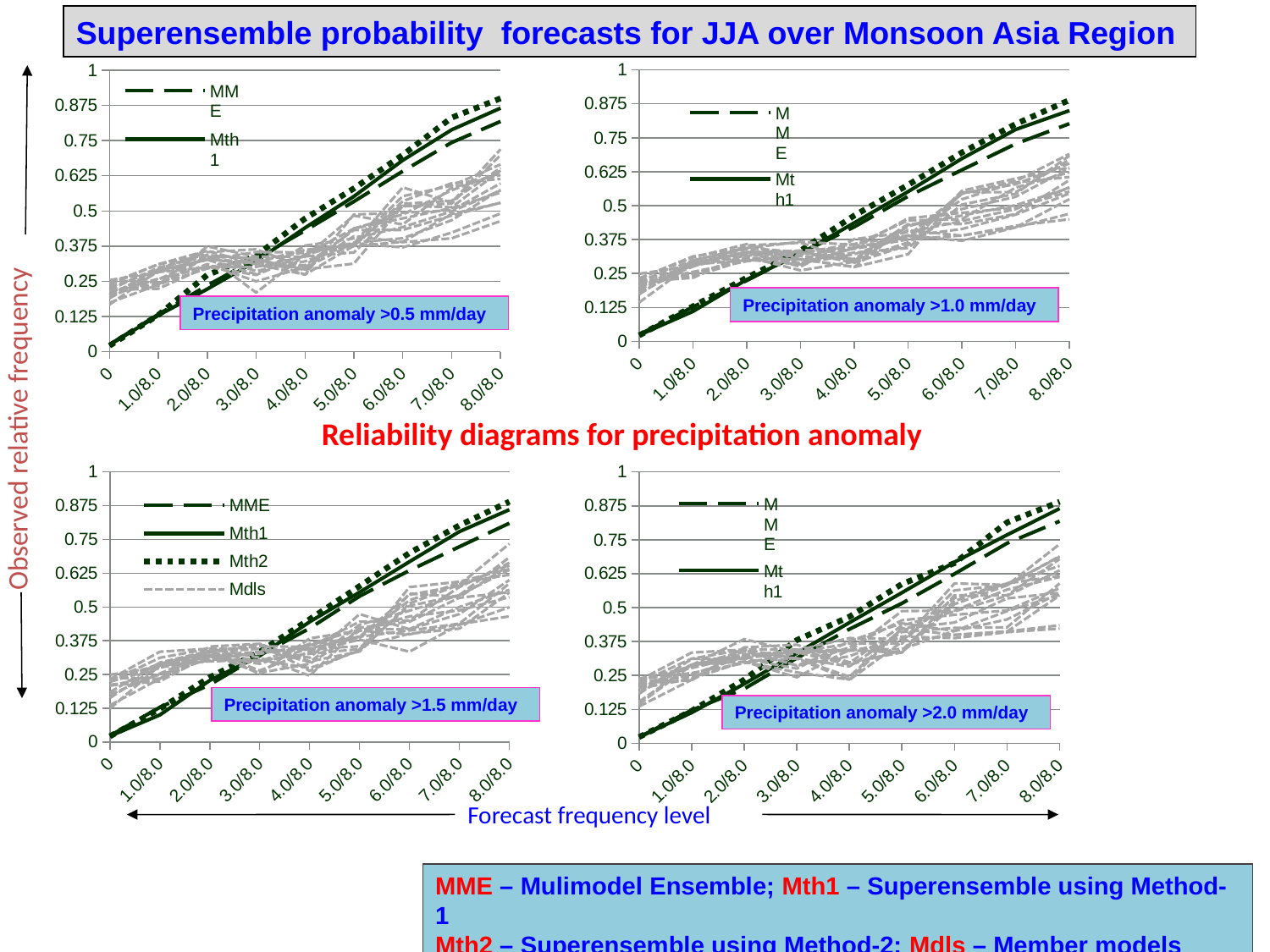
In the top-left chart (Precipitation anomaly >0.5 mm/day), does the Mth1 line rise or fall as the forecast frequency level increases from 0 to 8.0/8.0? rise What type of chart is the top-left chart (Precipitation anomaly >0.5 mm/day)? line chart What is the highest tick value shown on the y axis of the bottom-right chart (Precipitation anomaly >2.0 mm/day)? 1 How many tick labels are shown on the x axis of the top-right chart (Precipitation anomaly >1.0 mm/day)? 9 What is the label on the vertical axis shared by the four charts? Observed relative frequency In the top-left chart (Precipitation anomaly >0.5 mm/day), which is higher at 8.0/8.0: the Mth1 line or the MME line? Mth1 In the top-left chart (Precipitation anomaly >0.5 mm/day), is the Mth1 value at 8.0/8.0 greater or less than 0.75? greater In the bottom-right chart (Precipitation anomaly >2.0 mm/day), is the MME value at 8.0/8.0 greater or less than 0.625? greater In the bottom-left chart (Precipitation anomaly >1.5 mm/day), what are the legend entries? MME, Mth1, Mth2, Mdls In the bottom-left chart (Precipitation anomaly >1.5 mm/day), how many series does the legend list? 4 In the top-right chart (Precipitation anomaly >1.0 mm/day), is the MME value at 0 greater or less than 0.125? less In the bottom-left chart (Precipitation anomaly >1.5 mm/day), which is higher at 8.0/8.0: the Mth2 line or the MME line? Mth2